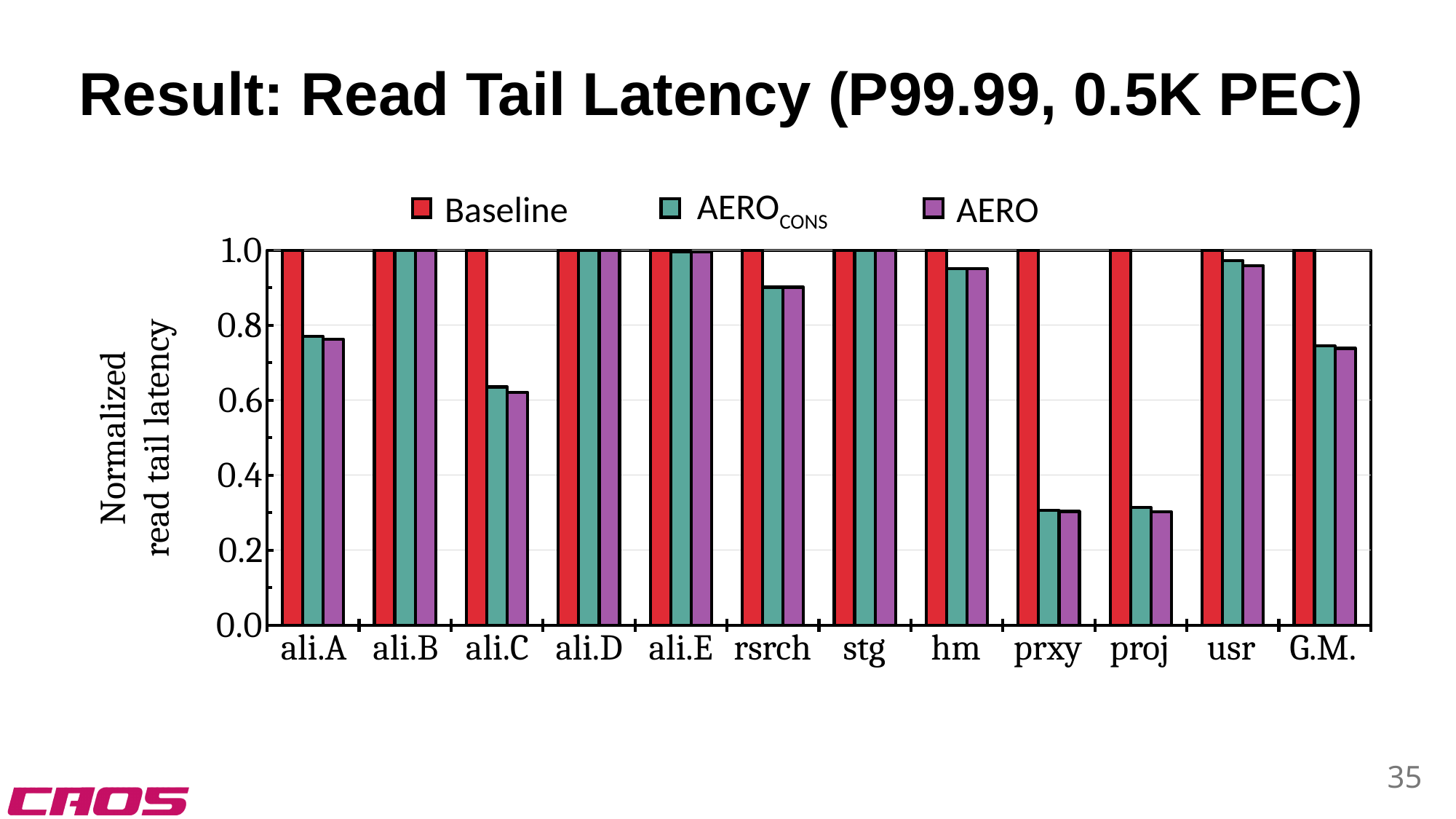
What is the Baseline value for G.M.? 1.0 Is the AERO value for ali.A greater or less than 0.8? less Is the AERO value for G.M. greater or less than 0.6? greater Is the AERO_CONS value for rsrch greater or less than 0.8? greater How many series does the legend list? 3 What kind of chart is shown on the slide? bar chart What is the Baseline value for ali.A? 1.0 Which is larger, the AERO value for prxy or the AERO value for rsrch? rsrch How many categories are shown along the x axis? 12 Which is larger, the AERO value for ali.A or the AERO value for ali.C? ali.A What is the label of the y axis? Normalized read tail latency